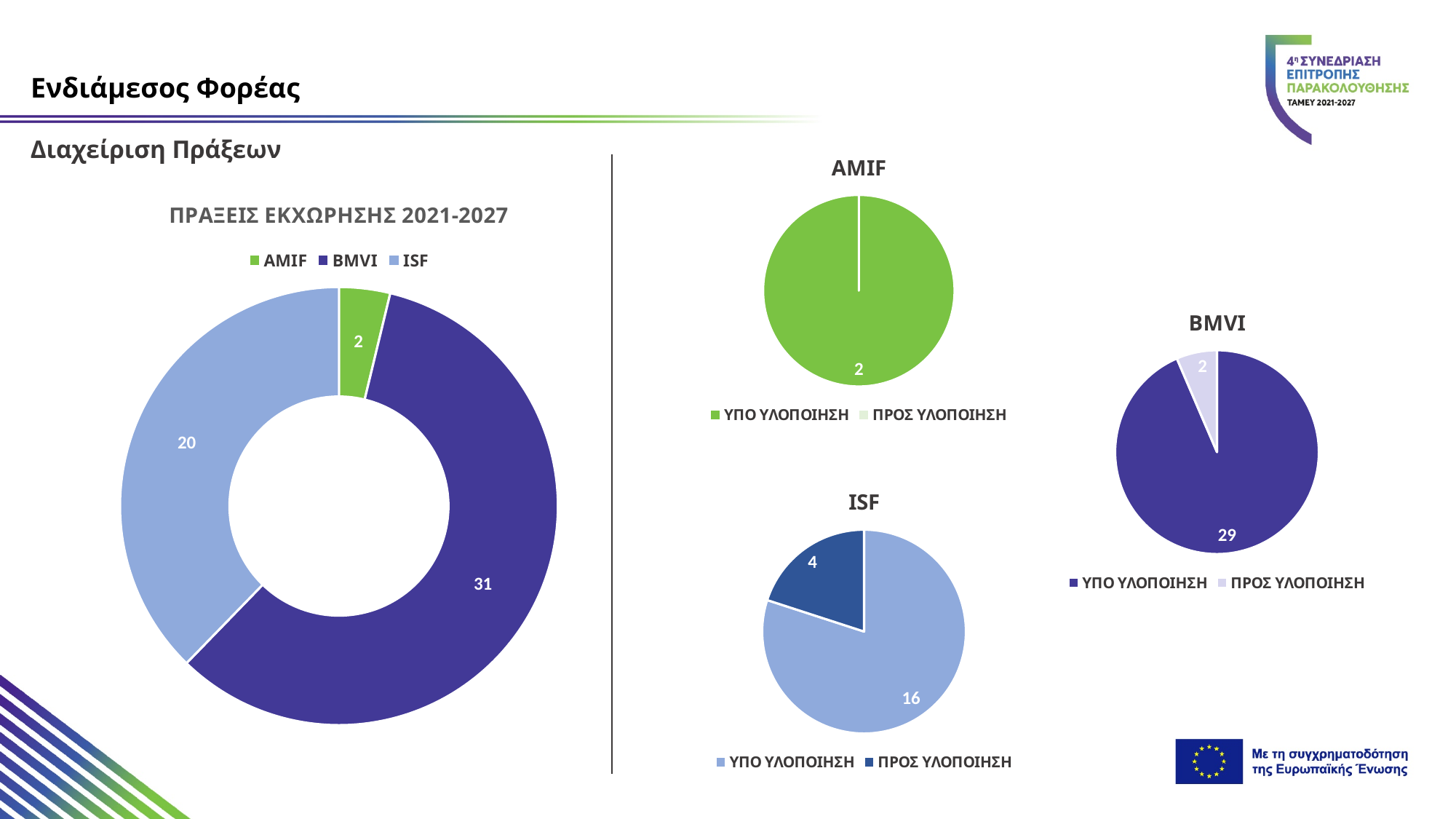
In the chart titled ΠΡΑΞΕΙΣ ΕΚΧΩΡΗΣΗΣ 2021-2027, what is the value for BMVI? 31 In the chart titled ΠΡΑΞΕΙΣ ΕΚΧΩΡΗΣΗΣ 2021-2027, which category has the lowest value? AMIF In the chart titled BMVI, what is the value for ΠΡΟΣ ΥΛΟΠΟΙΗΣΗ? 2 In the chart titled BMVI, what is the value for ΥΠΟ ΥΛΟΠΟΙΗΣΗ? 29 In the chart titled ΠΡΑΞΕΙΣ ΕΚΧΩΡΗΣΗΣ 2021-2027, what is the difference between the values for BMVI and ISF? 11 In the chart titled ΠΡΑΞΕΙΣ ΕΚΧΩΡΗΣΗΣ 2021-2027, which category has the highest value? BMVI In the chart titled ISF, what is the value for ΠΡΟΣ ΥΛΟΠΟΙΗΣΗ? 4 What kind of chart is the chart titled ΠΡΑΞΕΙΣ ΕΚΧΩΡΗΣΗΣ 2021-2027? Donut chart In the chart titled ΠΡΑΞΕΙΣ ΕΚΧΩΡΗΣΗΣ 2021-2027, how many categories does the legend list? 3 In the chart titled AMIF, what is the value shown on the pie? 2 In the chart titled ISF, which is larger, ΥΠΟ ΥΛΟΠΟΙΗΣΗ or ΠΡΟΣ ΥΛΟΠΟΙΗΣΗ? ΥΠΟ ΥΛΟΠΟΙΗΣΗ In the chart titled ΠΡΑΞΕΙΣ ΕΚΧΩΡΗΣΗΣ 2021-2027, what is the value for ISF? 20